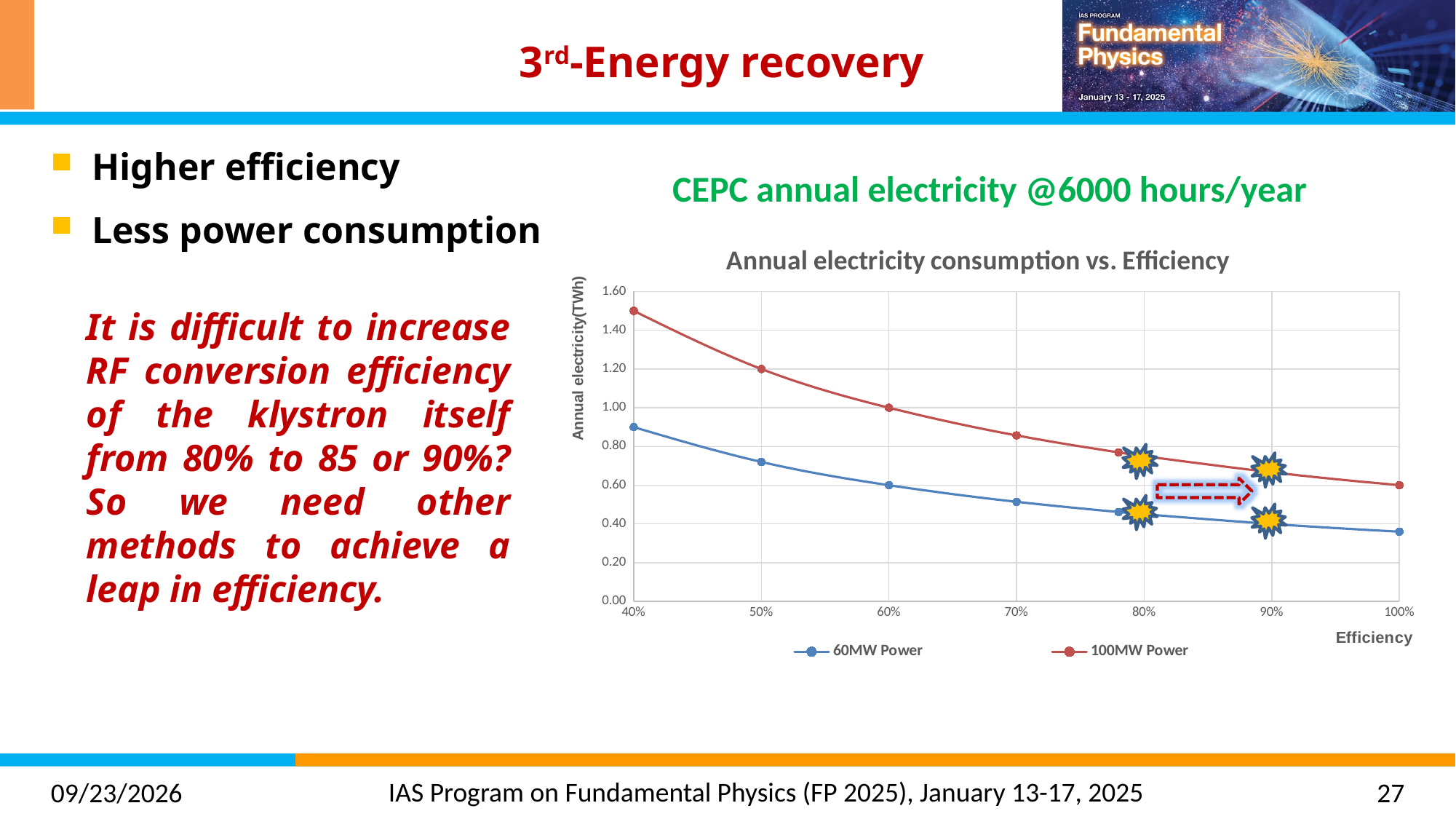
Is the value for 100MW Power at 70% efficiency greater or less than 0.80? greater At 70% efficiency, which series has the larger value, 60MW Power or 100MW Power? 100MW Power Do the values for 100MW Power rise or fall as efficiency increases along the x axis? fall Is the value for 60MW Power at 40% efficiency greater or less than 0.80? greater What kind of chart is shown on the slide? line chart Is the value for 100MW Power at 40% efficiency greater or less than 1.40? greater What is the title of the chart? Annual electricity consumption vs. Efficiency At which efficiency does the 100MW Power series reach its highest value? 40% How many series does the chart legend list? 2 What are the two series named in the chart legend? 60MW Power and 100MW Power